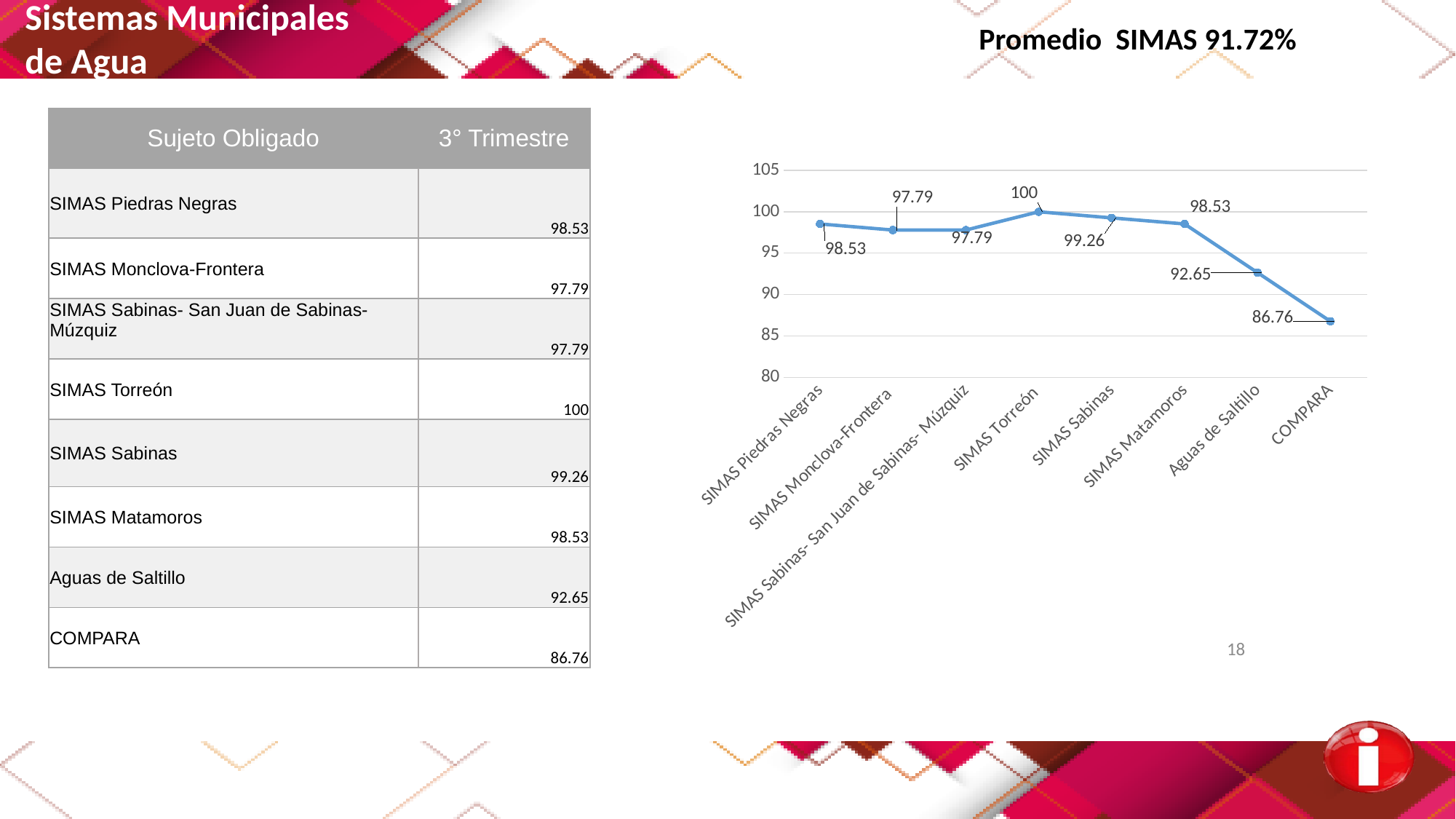
How many categories are plotted on the x axis of the chart? 8 What kind of chart is shown on the slide? line chart Which is larger, the value for SIMAS Sabinas or the value for SIMAS Matamoros? SIMAS Sabinas What is the value for Aguas de Saltillo in the chart? 92.65 What is the value for SIMAS Torreón in the chart? 100 Which category has the lowest value in the chart? COMPARA What is the difference between the values for SIMAS Torreón and COMPARA? 13.24 Do the values rise or fall from SIMAS Matamoros to COMPARA along the x axis? fall Which category has the highest value in the chart? SIMAS Torreón What is the value for COMPARA in the chart? 86.76 Is the value for Aguas de Saltillo greater or less than 95? less What is the value for SIMAS Sabinas in the chart? 99.26